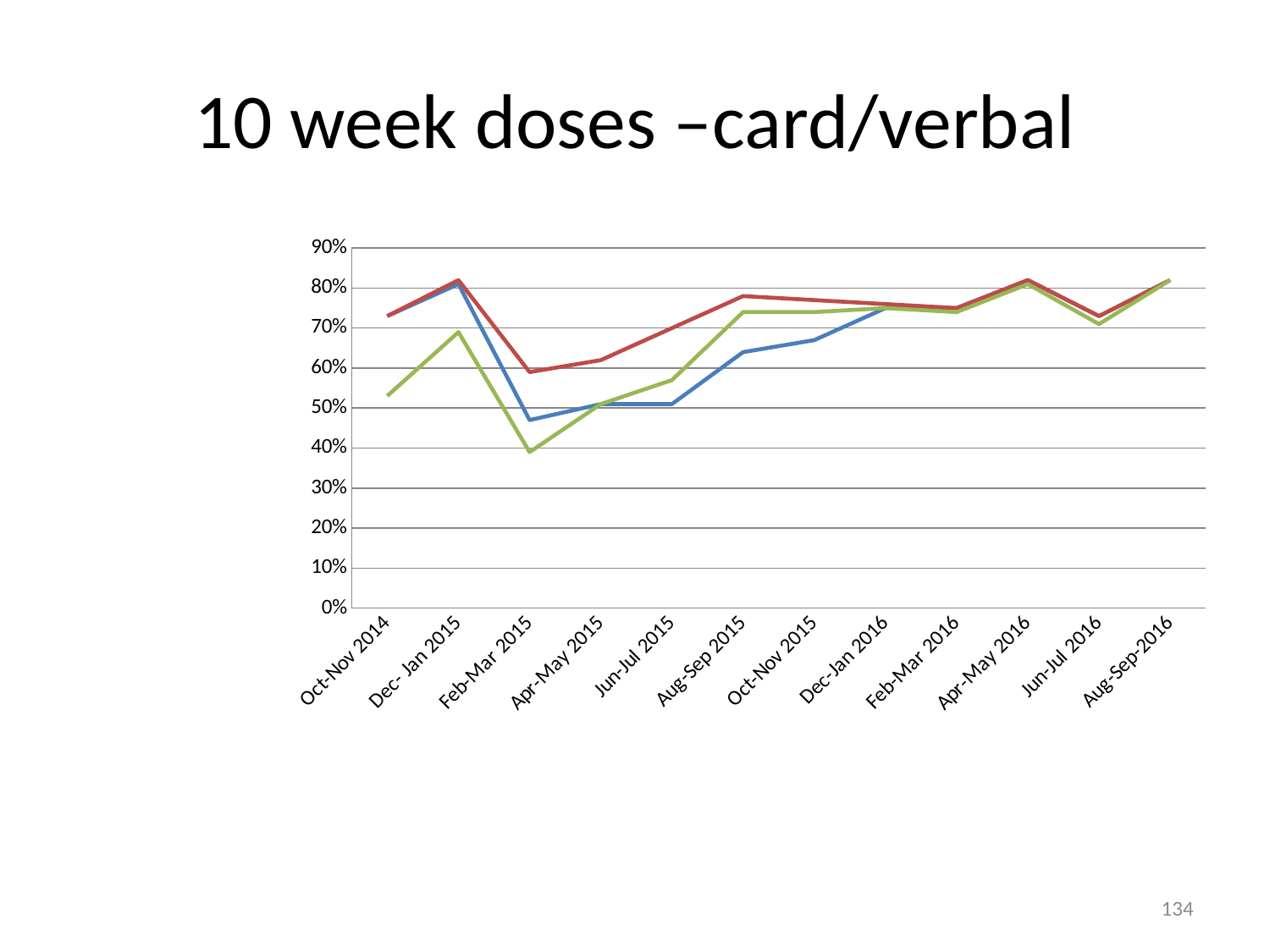
How many lines are plotted on the chart? 3 At Oct-Nov 2014, which line has the higher value, the red line or the green line? red line Is the value of the red line at Feb-Mar 2015 greater or less than 70%? less Is the value of the blue line at Apr-May 2015 greater or less than 60%? less Do the lines rise or fall between Dec- Jan 2015 and Feb-Mar 2015? fall Is the value of the red line at Aug-Sep 2015 greater or less than 70%? greater At which period does the green line reach its lowest value? Feb-Mar 2015 What is the title of the chart on the slide? 10 week doses –card/verbal At which period does the red line reach its lowest value? Feb-Mar 2015 How many time periods are shown along the x axis? 12 What kind of chart is shown on the slide? line chart